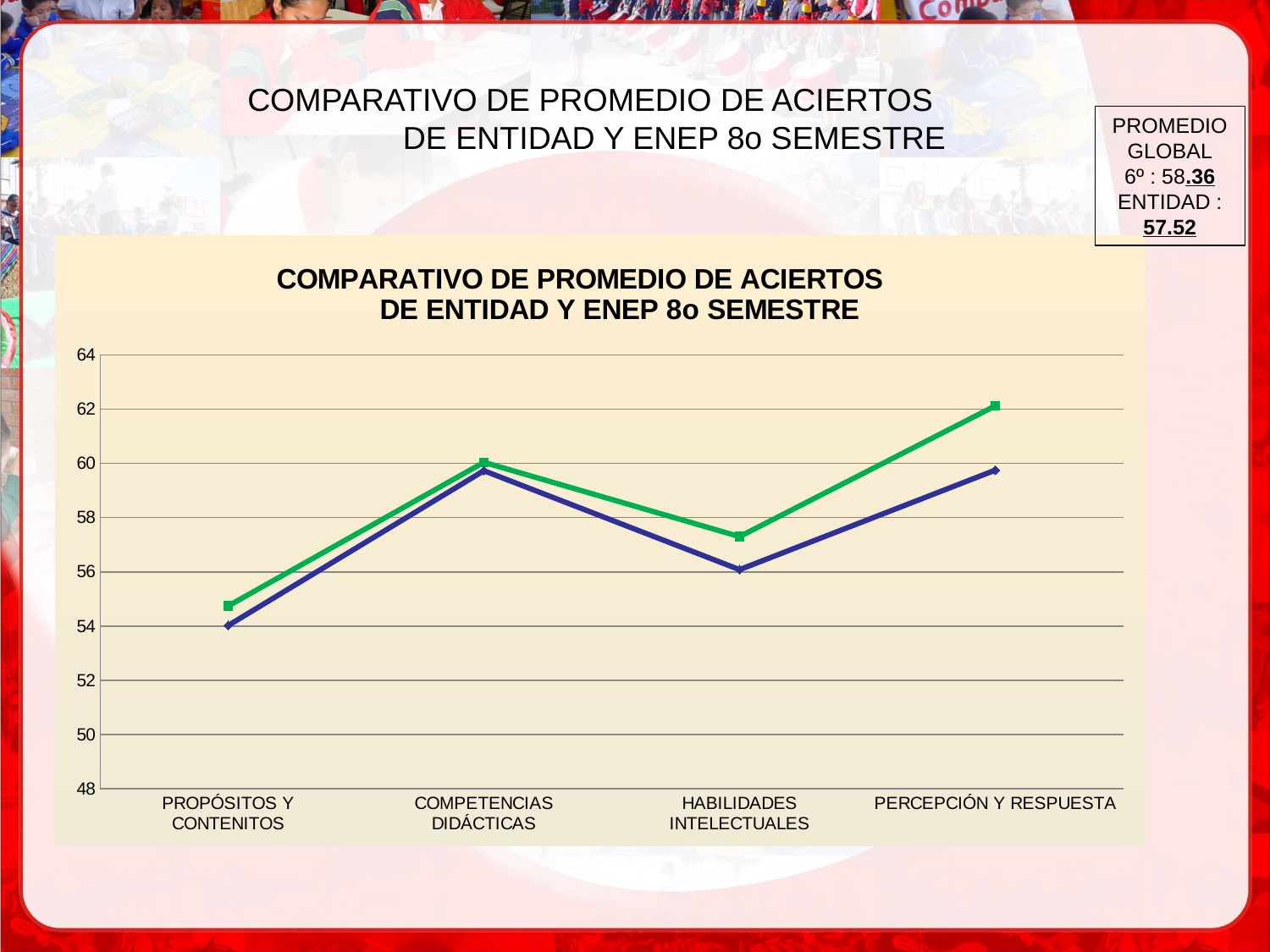
How many lines are plotted on the chart? 2 Is the value of the blue line for PROPÓSITOS Y CONTENITOS greater or less than 56? less Do both lines rise or fall from HABILIDADES INTELECTUALES to PERCEPCIÓN Y RESPUESTA? Rise Which category has the lowest value on the green line? PROPÓSITOS Y CONTENITOS Is the value of the green line for PERCEPCIÓN Y RESPUESTA greater or less than 60? greater Is the value of the green line for HABILIDADES INTELECTUALES greater or less than 56? greater What is the title of the chart? COMPARATIVO DE PROMEDIO DE ACIERTOS DE ENTIDAD Y ENEP 8o SEMESTRE At PERCEPCIÓN Y RESPUESTA, which line has the higher value, the green line or the blue line? The green line How many categories are shown on the x axis of the chart? 4 Which category has the lowest value on the blue line? PROPÓSITOS Y CONTENITOS Which category has the highest value on the green line? PERCEPCIÓN Y RESPUESTA What kind of chart is shown on the slide? Line chart